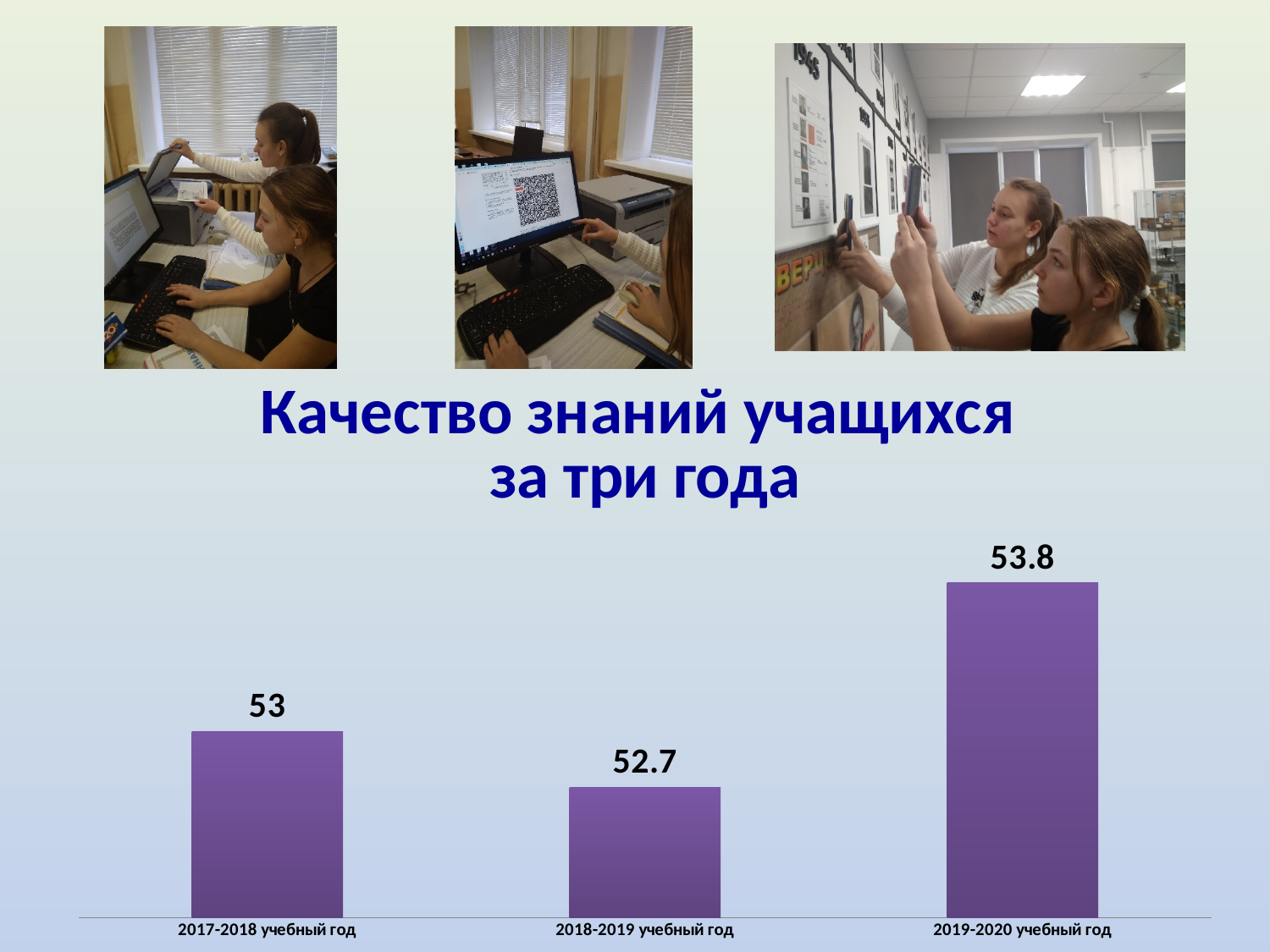
Which academic year has the highest value? 2019-2020 учебный год Which academic year has the lowest value? 2018-2019 учебный год Does the value rise or fall from 2018-2019 учебный год to 2019-2020 учебный год? rise What kind of chart is shown on the slide? bar chart What is the value for 2017-2018 учебный год? 53 What is the difference between the values for 2019-2020 учебный год and 2017-2018 учебный год? 0.8 How many academic years are shown in the chart? 3 What is the value for 2019-2020 учебный год? 53.8 Which is larger, the value for 2017-2018 учебный год or 2018-2019 учебный год? 2017-2018 учебный год What is the value for 2018-2019 учебный год? 52.7 What is the title of the chart? Качество знаний учащихся за три года What is the difference between the values for 2019-2020 учебный год and 2018-2019 учебный год? 1.1